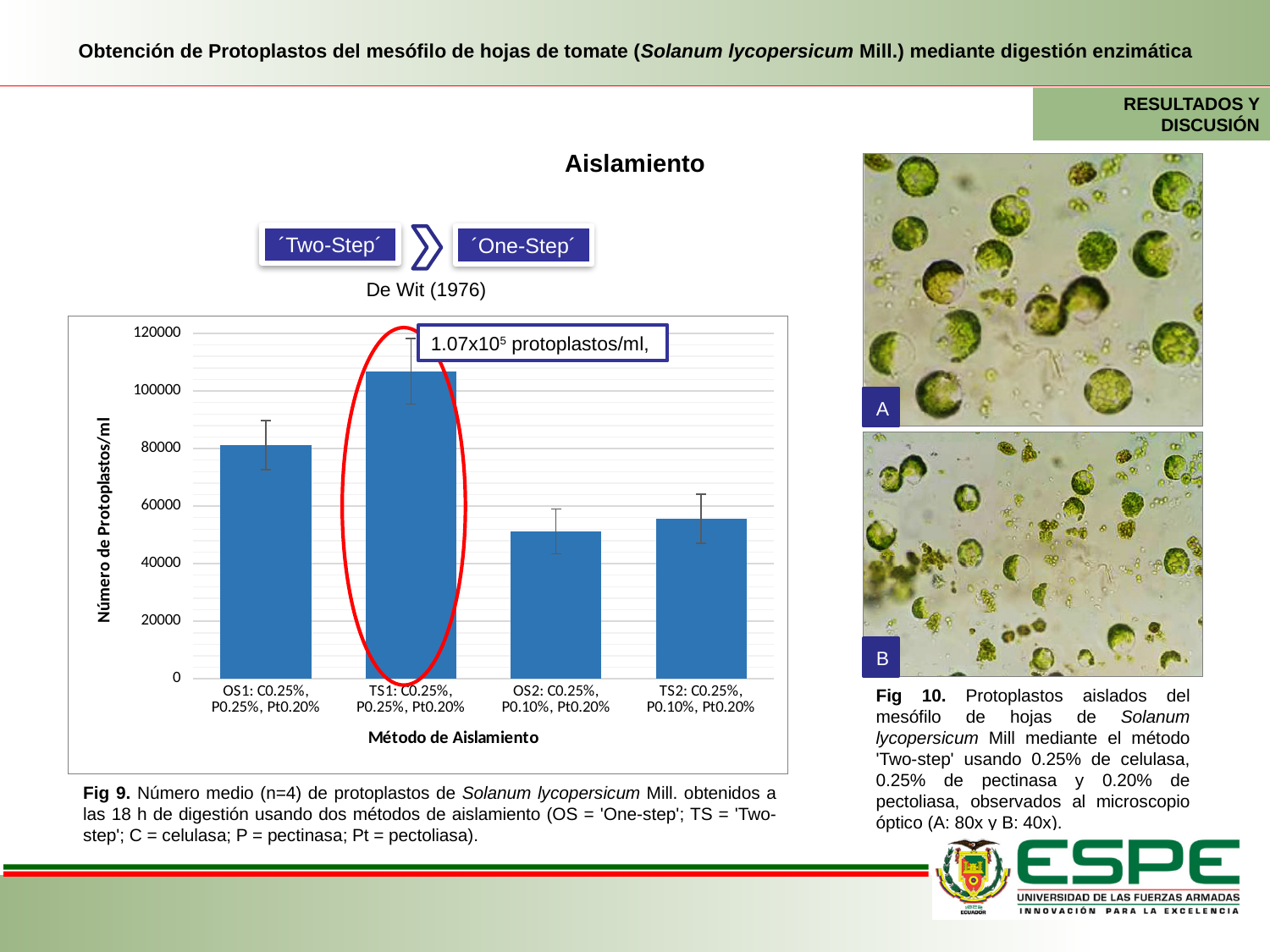
Is the value for OS2: C0.25%, P0.10%, Pt0.20% greater or less than 60000? less According to the annotation on the chart, what value is highlighted for the TS1 bar? 1.07x10⁵ protoplastos/ml Which has a larger number of protoplasts per ml, TS1 or TS2? TS1 What is the title of the x axis of the chart? Método de Aislamiento Is the value for TS2: C0.25%, P0.10%, Pt0.20% greater or less than 40000? greater Is the value for TS1: C0.25%, P0.25%, Pt0.20% greater or less than 100000? greater Which isolation method has the highest number of protoplasts per ml in the chart? TS1: C0.25%, P0.25%, Pt0.20% What is the title of the y axis of the chart? Número de Protoplastos/ml How many isolation methods (categories) are plotted on the x axis of the chart? 4 Which has a larger number of protoplasts per ml, OS1 or OS2? OS1 What kind of chart is shown on the slide? bar chart